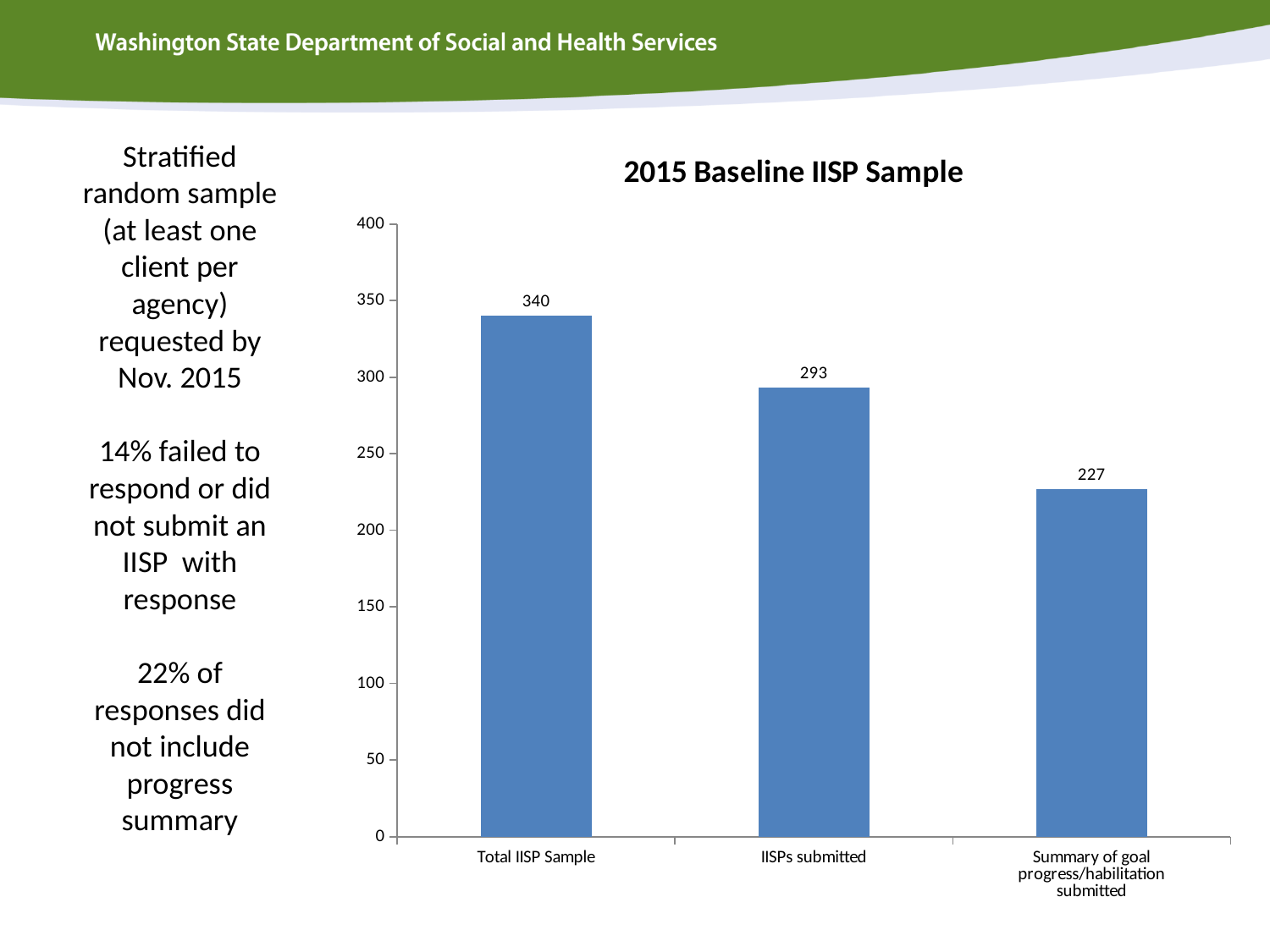
How many categories are shown on the chart? 3 Which is larger, IISPs submitted or Summary of goal progress/habilitation submitted? IISPs submitted Which category has the lowest value? Summary of goal progress/habilitation submitted What is the title of the chart? 2015 Baseline IISP Sample What is the difference between IISPs submitted and Summary of goal progress/habilitation submitted? 66 Which category has the highest value? Total IISP Sample What is the difference between Total IISP Sample and IISPs submitted? 47 What is the value for Summary of goal progress/habilitation submitted? 227 Is the value for IISPs submitted greater or less than 250? greater What kind of chart is shown on the slide? bar chart What is the value for Total IISP Sample? 340 What is the value for IISPs submitted? 293